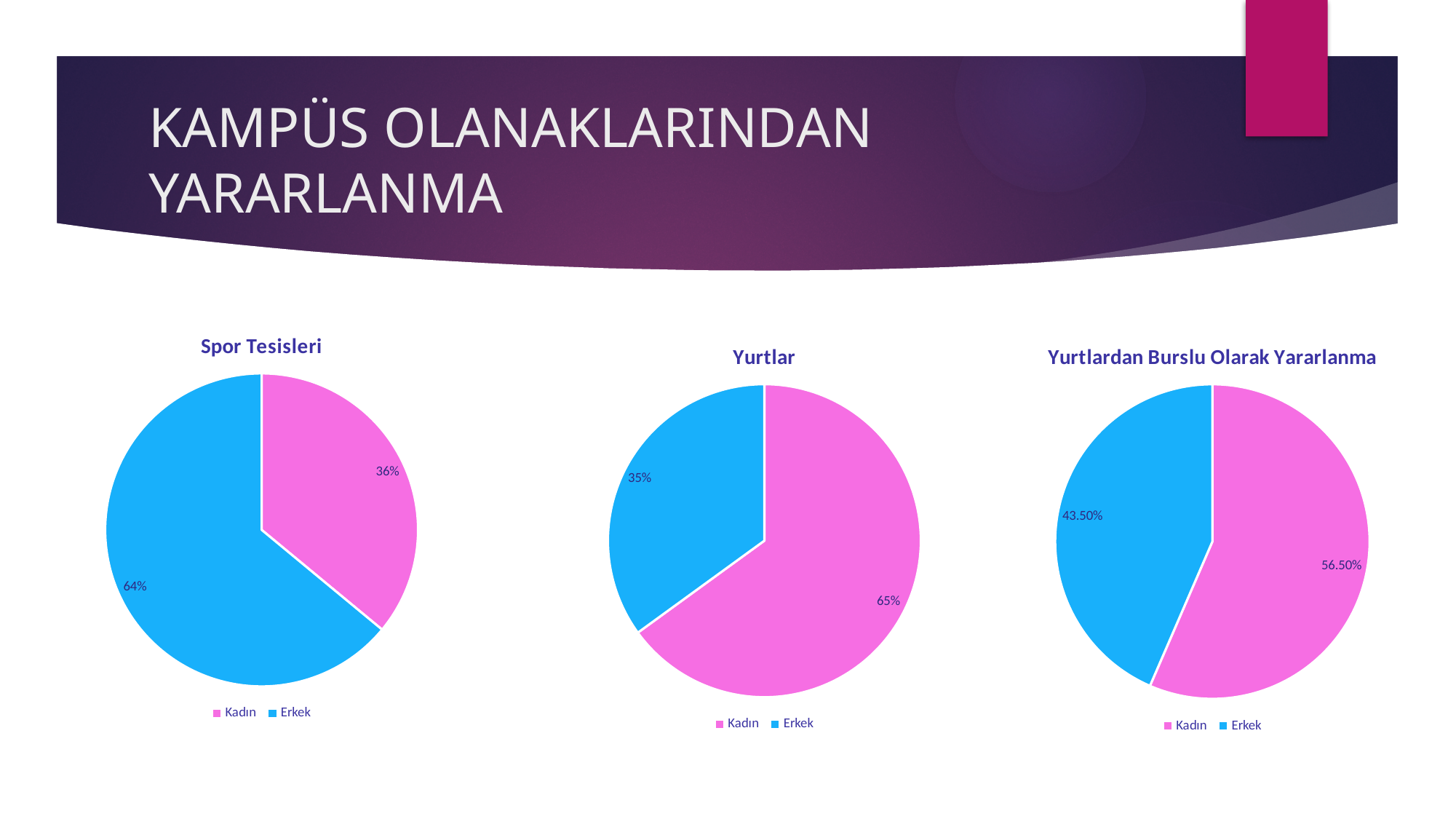
In the 'Yurtlar' chart, what is the value for Kadın? 65% In the 'Spor Tesisleri' chart, what is the value for Erkek? 64% In the 'Yurtlardan Burslu Olarak Yararlanma' chart, which is larger, Kadın or Erkek? Kadın In the 'Spor Tesisleri' chart, which category has the largest share? Erkek What type of chart is the 'Yurtlar' chart? Pie chart In the 'Spor Tesisleri' chart, what is the value for Kadın? 36% How many categories does the legend of the 'Spor Tesisleri' chart list? 2 In the 'Yurtlardan Burslu Olarak Yararlanma' chart, what is the value for Kadın? 56.50% In the 'Yurtlar' chart, what is the difference between the Kadın and Erkek values? 30% In the 'Yurtlardan Burslu Olarak Yararlanma' chart, what is the value for Erkek? 43.50% In the 'Yurtlar' chart, which category has the smallest share? Erkek In the 'Spor Tesisleri' chart, what is the difference between the Erkek and Kadın values? 28%